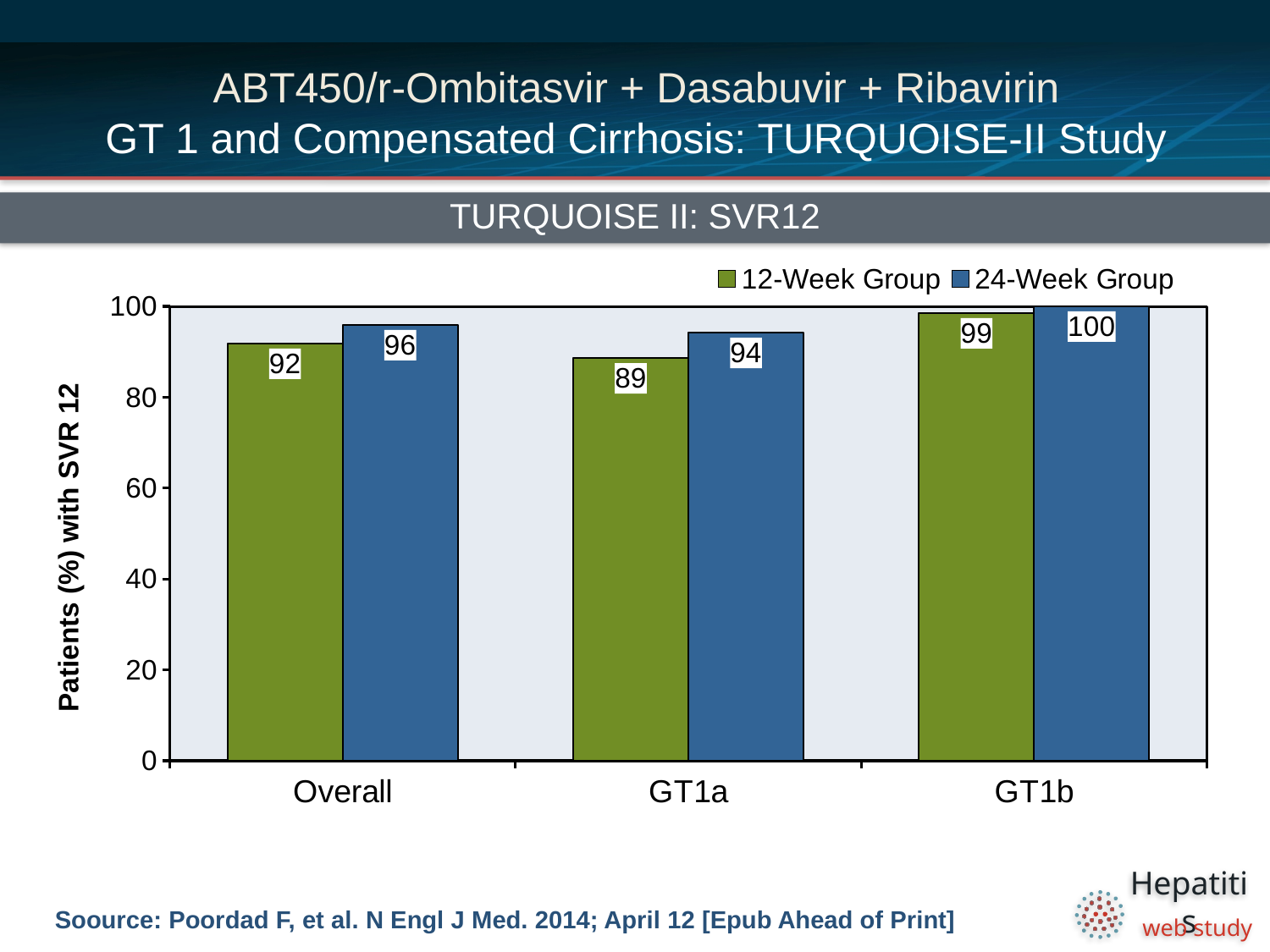
In the Overall category, which group has the higher SVR12 rate? 24-Week Group How many series does the legend list? 2 What is the SVR12 rate for the 12-Week Group in the Overall category? 92 Which category has the lowest value for the 12-Week Group? GT1a How many categories are shown on the x axis? 3 What is the SVR12 rate for the 24-Week Group in the GT1a category? 94 What is the SVR12 rate for the 24-Week Group in the GT1b category? 100 What is the difference between the 24-Week Group and 12-Week Group values in the Overall category? 4 What kind of chart is shown on the slide? Bar chart What is the label of the y axis? Patients (%) with SVR 12 Which category has the highest value for the 24-Week Group? GT1b What is the difference between the 24-Week Group and 12-Week Group values in the GT1a category? 5